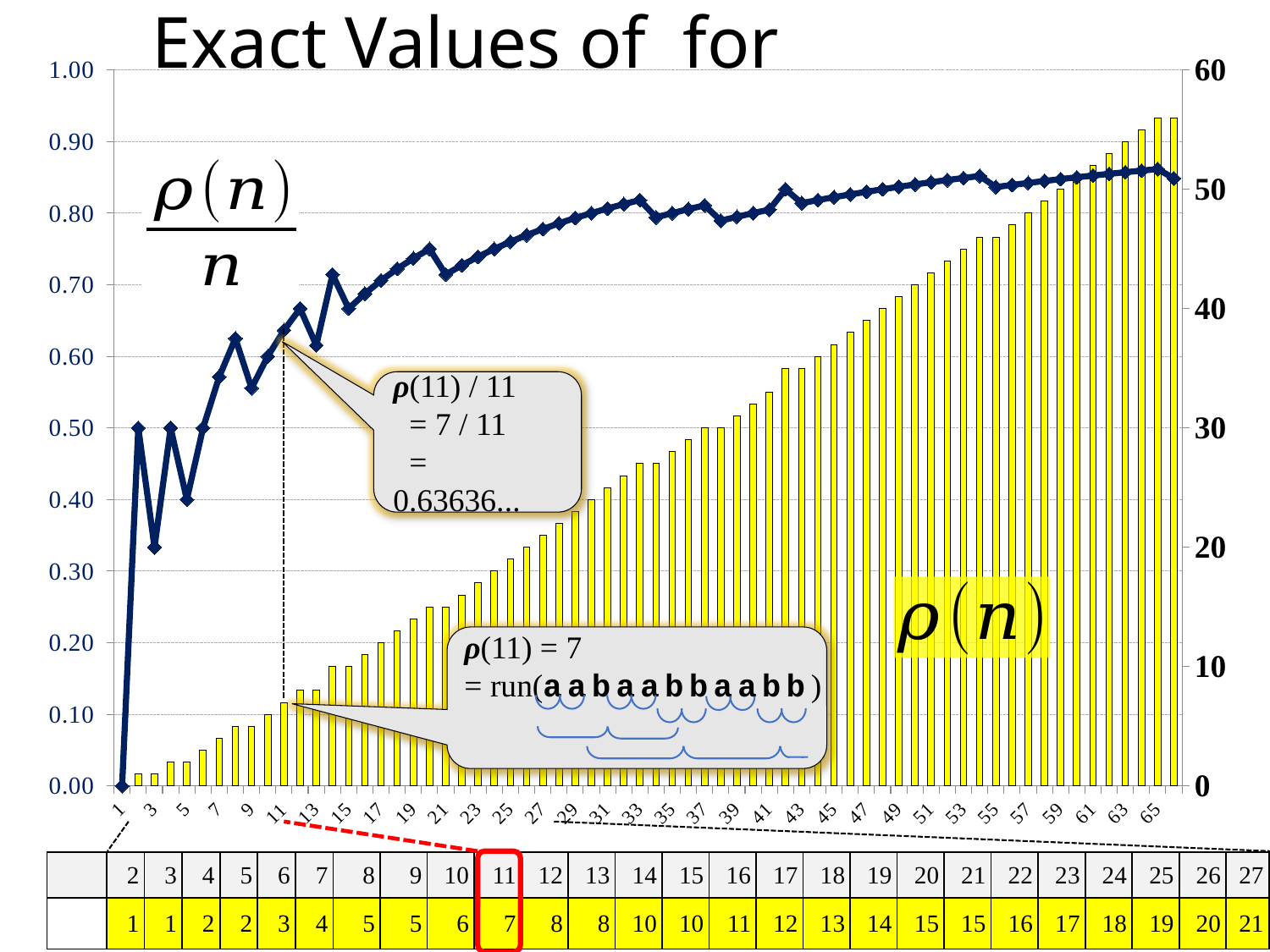
According to the table below the chart, what is ρ(n) for n = 27? 21 What colour are the ρ(n) bars on the chart? Yellow According to the table below the chart, what is ρ(n) for n = 20? 15 Is the value of the ρ(n)/n line at n = 65 greater or less than 0.80? greater Is the ρ(n) bar at n = 65 greater or less than 50 on the right axis? greater At which value of n is the ρ(n)/n line at its lowest? 1 What is the difference between ρ(27) and ρ(11) as given in the table below the chart? 14 Do the ρ(n) bars generally rise or fall as n increases along the x axis? rise According to the callout on the chart, what is the value of ρ(11)? 7 Which is larger, the ρ(n) bar at n = 25 or at n = 45? n = 45 According to the callout on the chart, what is the value of ρ(11)/11? 0.63636... What kind of chart is shown on the slide? A combined bar and line chart